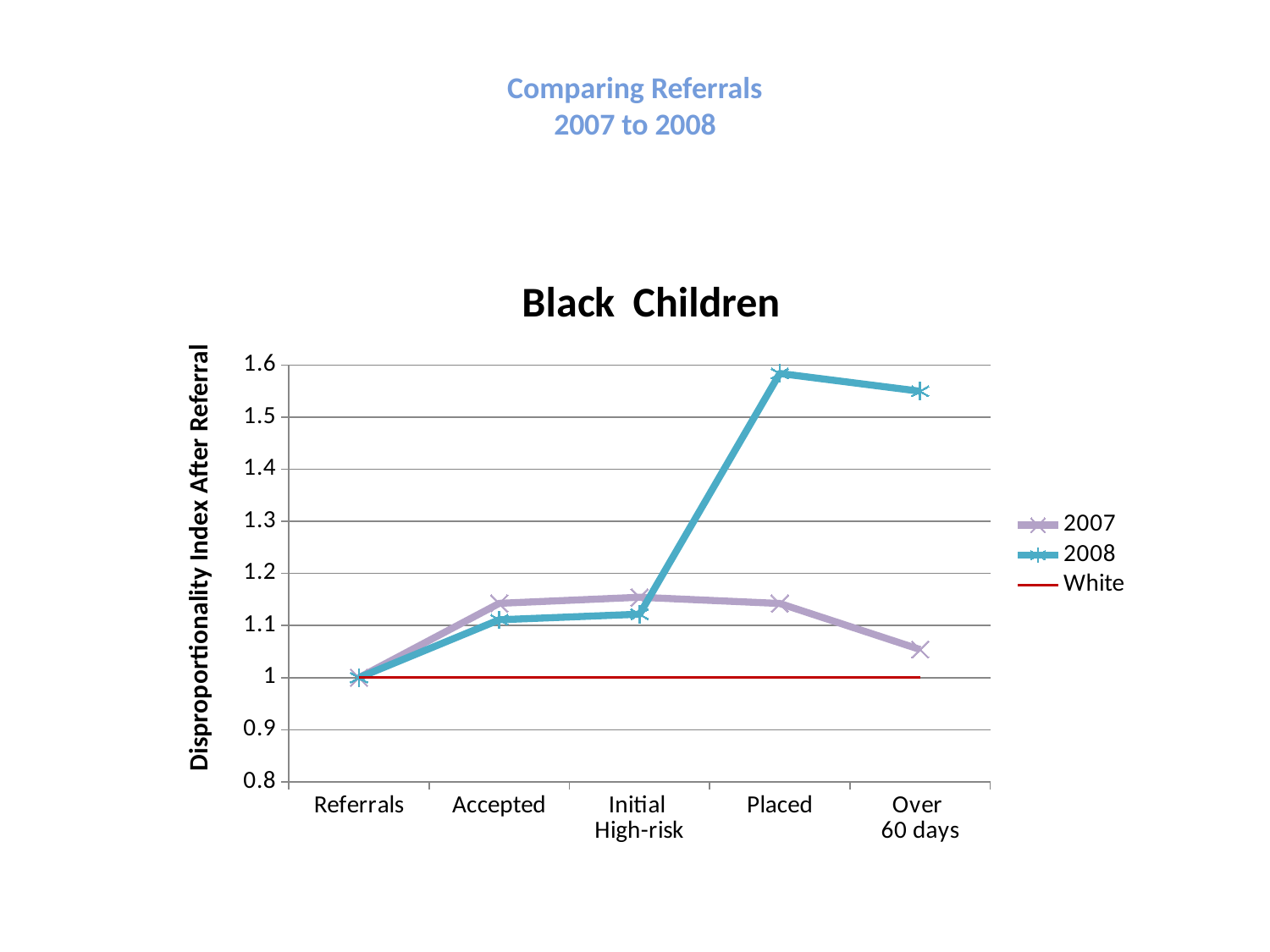
Is the 2007 value for Accepted greater or less than 1.1? greater How many categories are shown on the x axis? 5 How many series does the legend list? 3 At Placed, which series has the larger value, 2007 or 2008? 2008 Is the 2008 value for Placed greater or less than 1.5? greater Is the 2008 value for Accepted greater or less than 1.2? less Does the 2008 series rise or fall from Referrals to Placed? rise What is the value of the White series across all categories? 1 For the 2007 series, which category has the lowest value? Referrals What kind of chart is shown on the slide? line chart What is the title of the chart? Black Children For the 2008 series, which category has the highest value? Placed